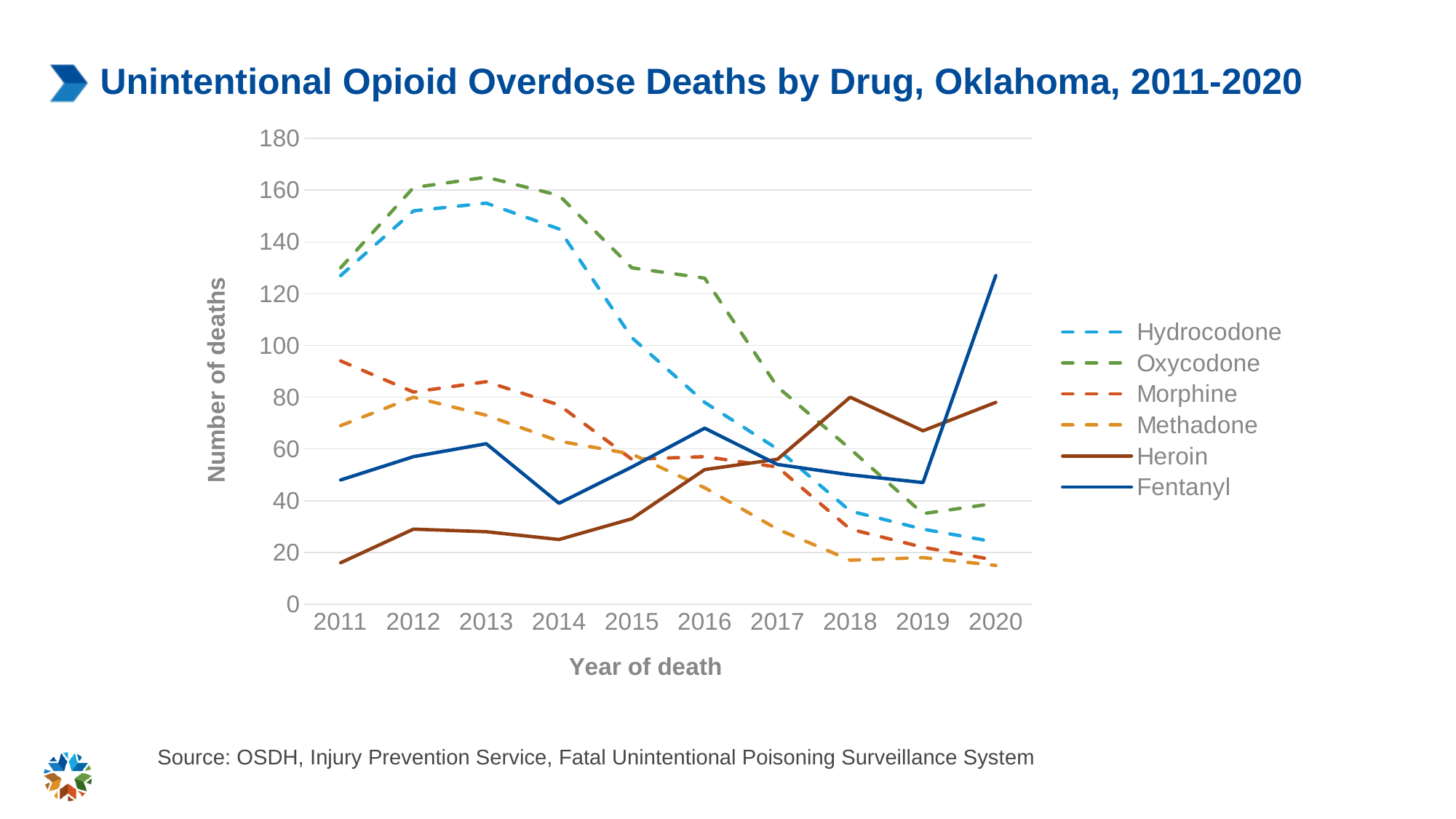
Do the values for Hydrocodone rise or fall from 2013 to 2020? fall Which drug has the highest number of deaths in 2020? Fentanyl Is the value for Methadone in 2020 greater or less than 20? less In 2011, which is larger: the value for Morphine or the value for Heroin? Morphine Which drug has the lowest number of deaths in 2011? Heroin Is the value for Oxycodone in 2013 greater or less than 140? greater Is the value for Heroin in 2018 greater or less than 60? greater What is the title of the y axis? Number of deaths What kind of chart is shown on the slide? line chart How many years are shown on the x axis? 10 How many series does the legend list? 6